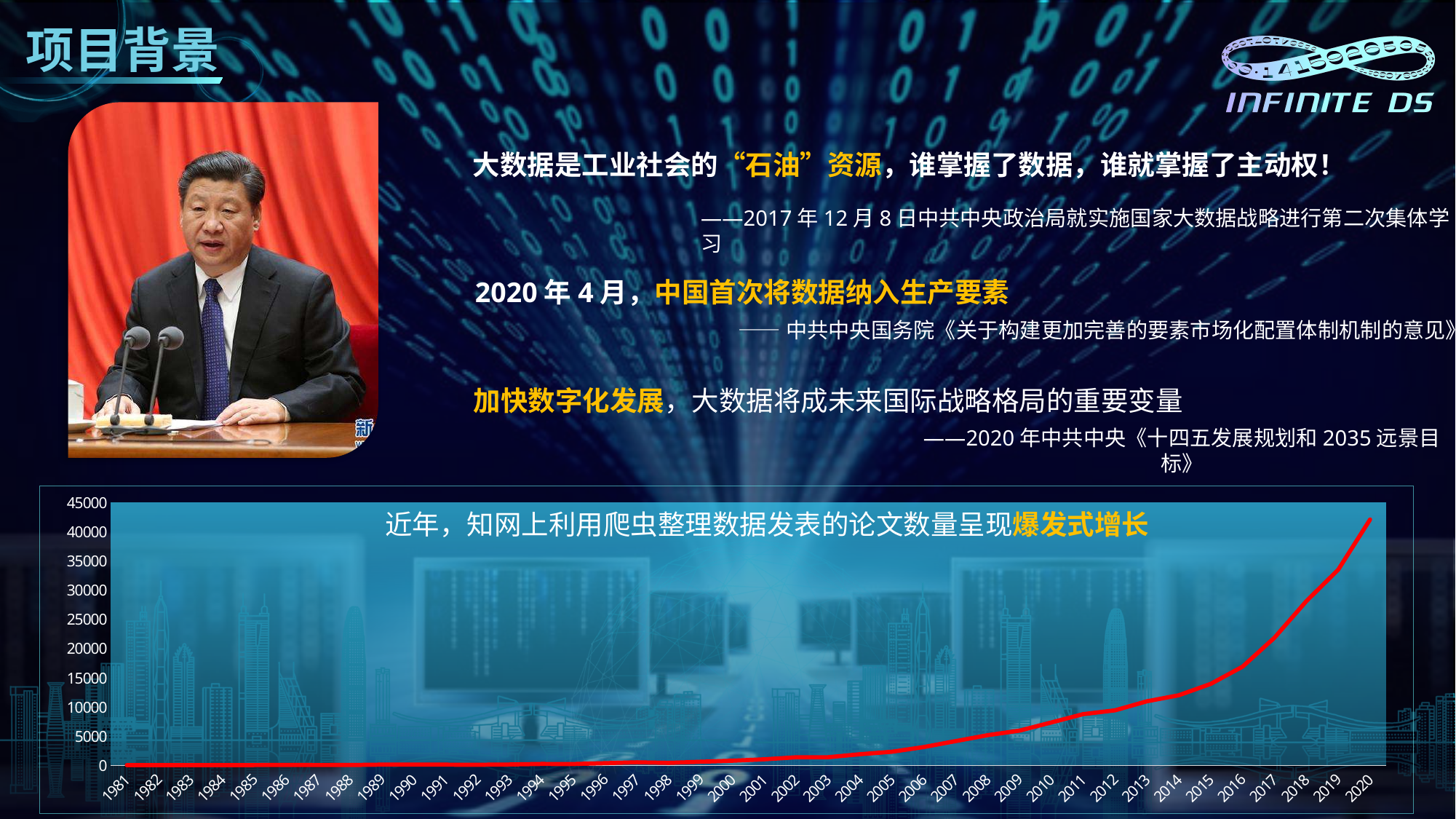
Is the value for 2017 in the line chart greater or less than 25000? less How many years are shown on the x axis of the line chart? 40 Is the value for 2019 in the line chart greater or less than 30000? greater Is the value for 2020 in the line chart greater or less than 40000? greater Which year has the highest value in the line chart? 2020 Do the values in the line chart rise or fall from 1981 to 2020? rise What kind of chart is shown at the bottom of the slide? line chart What is the first year shown on the x axis of the line chart? 1981 Which year has the larger value in the line chart, 2015 or 2019? 2019 What is the highest tick value shown on the y axis of the line chart? 45000